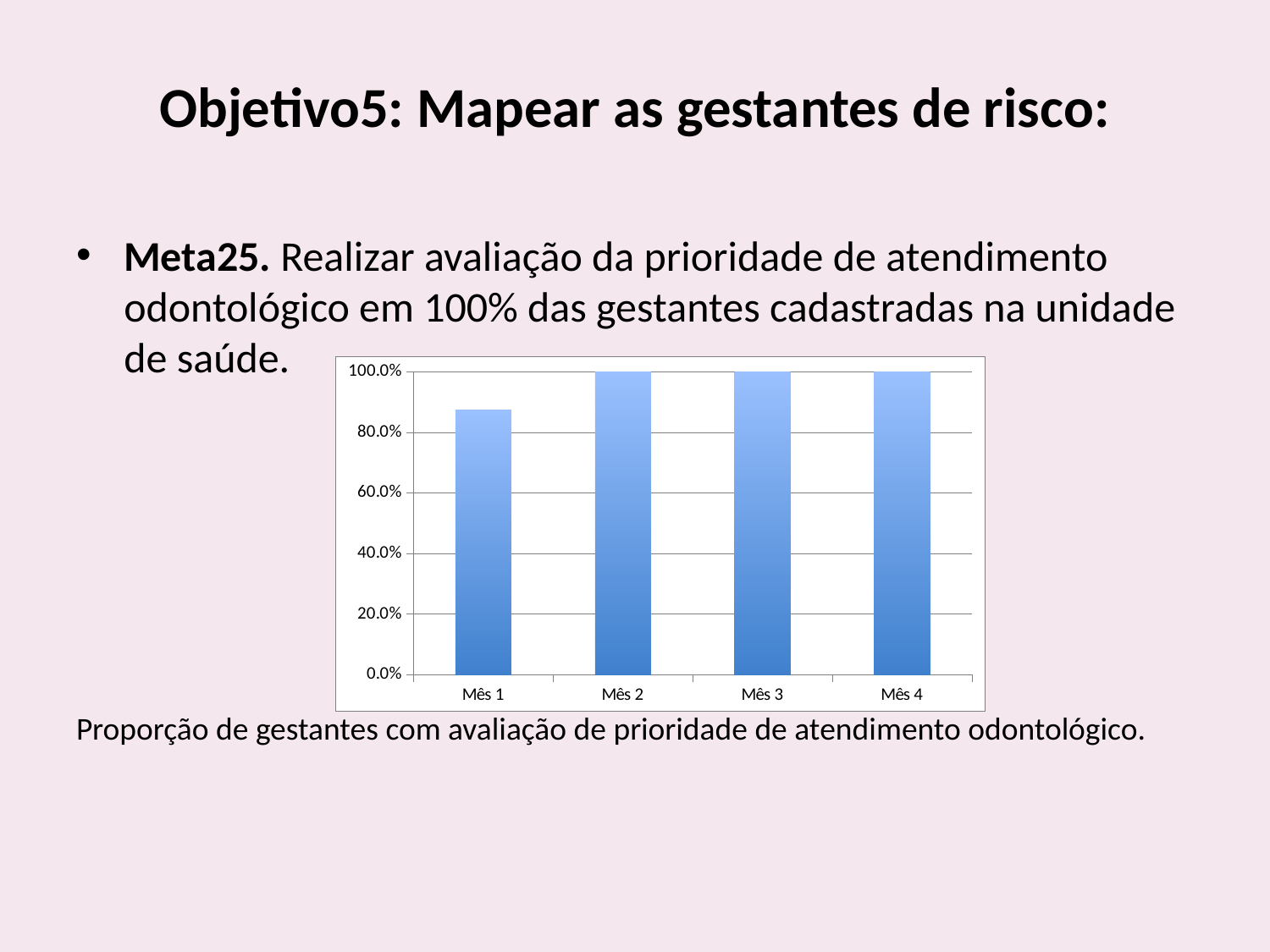
Which month has the lowest value in the chart? Mês 1 What is the value for Mês 2 in the chart? 100.0% Is the value for Mês 1 greater or less than 80.0%? greater Do the values rise or fall from Mês 1 to Mês 2? rise Is the value for Mês 1 greater or less than 100.0%? less Which is larger, the value for Mês 1 or the value for Mês 3? Mês 3 What is the highest value shown on the y axis of the chart? 100.0% How many categories are shown on the x axis of the chart? 4 What does the caption below the chart say the chart shows? Proporção de gestantes com avaliação de prioridade de atendimento odontológico. What kind of chart is shown on the slide? bar chart What is the value for Mês 4 in the chart? 100.0%